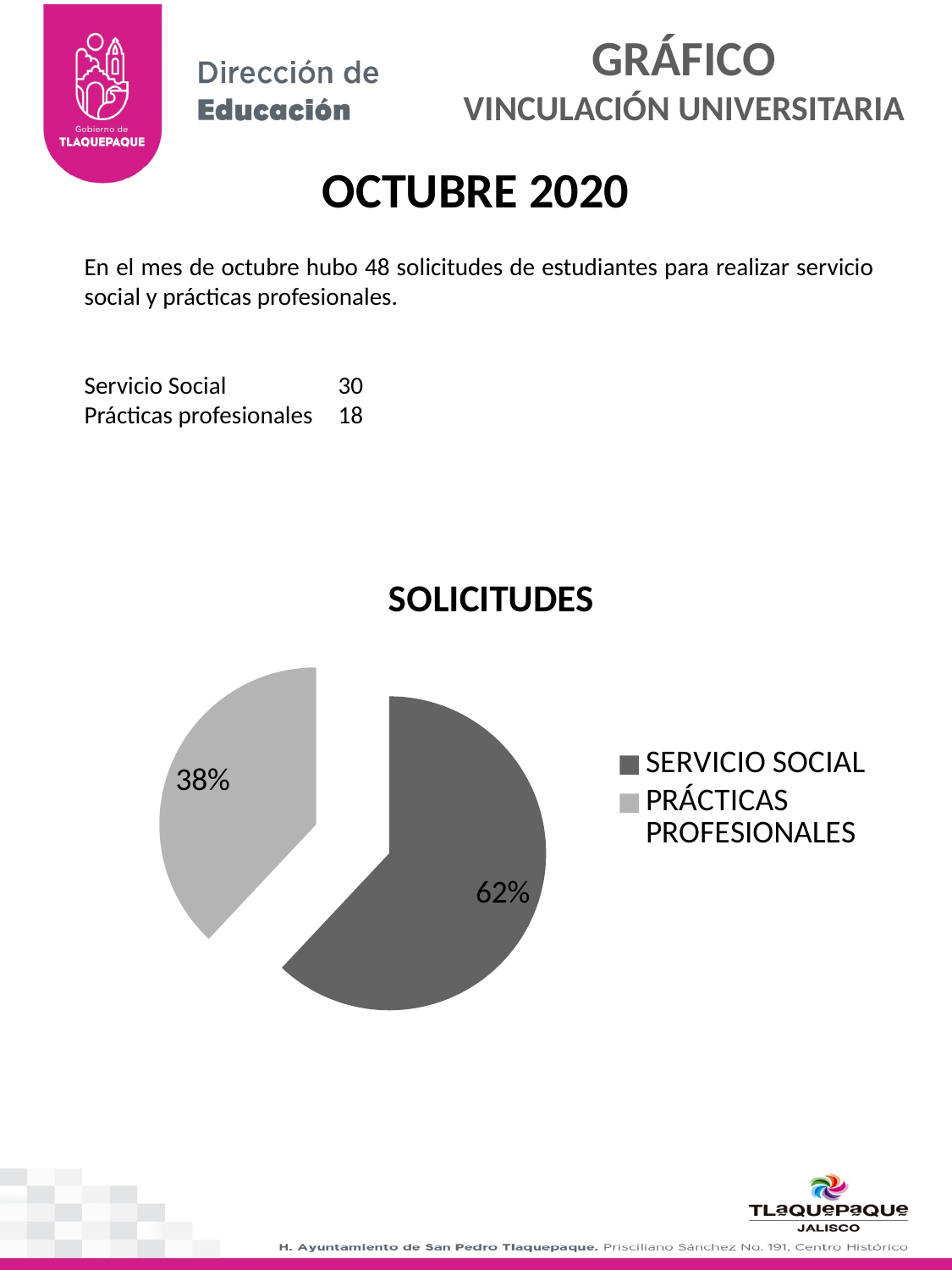
What percentage share does the SERVICIO SOCIAL slice have? 62% Which legend entry is shown in the lighter grey colour? PRÁCTICAS PROFESIONALES What is the title of the chart? SOLICITUDES What is the difference in percentage points between the SERVICIO SOCIAL and PRÁCTICAS PROFESIONALES slices? 24% What kind of chart is shown on the slide? pie chart How many entries does the legend list? 2 Which slice of the pie is the smallest? PRÁCTICAS PROFESIONALES What percentage share does the PRÁCTICAS PROFESIONALES slice have? 38% Which slice of the pie is the largest? SERVICIO SOCIAL How many slices does the pie chart have? 2 Which is larger, the SERVICIO SOCIAL slice or the PRÁCTICAS PROFESIONALES slice? SERVICIO SOCIAL